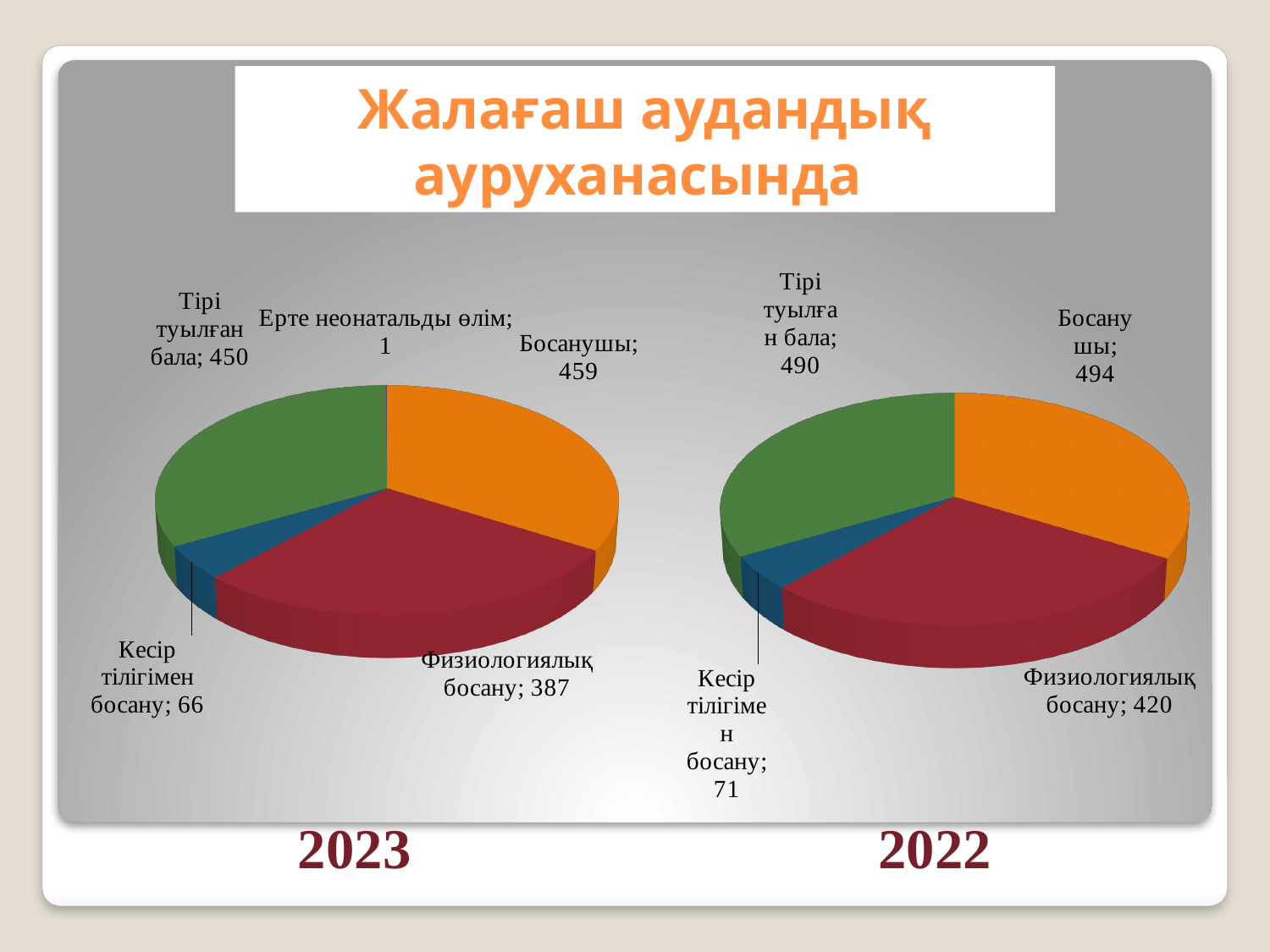
How many categories are labelled in the 2023 pie chart? 5 In the 2022 pie chart, what is the value for Физиологиялық босану? 420 In the 2023 pie chart, what is the value for Босанушы? 459 In the 2022 pie chart, what is the value for Тірі туылған бала? 490 What is the difference between Физиологиялық босану and Кесір тілігімен босану in the 2023 pie chart? 321 Which is larger: Кесір тілігімен босану in 2023 or in 2022? 2022 In the 2023 pie chart, what is the value for Ерте неонатальды өлім? 1 What type of chart is used on this slide? Pie chart In the 2022 pie chart, which category has the largest value? Босанушы In the 2023 pie chart, what is the value for Кесір тілігімен босану? 66 What is the difference between Босанушы in 2022 and Босанушы in 2023? 35 In the 2023 pie chart, which category has the smallest value? Ерте неонатальды өлім